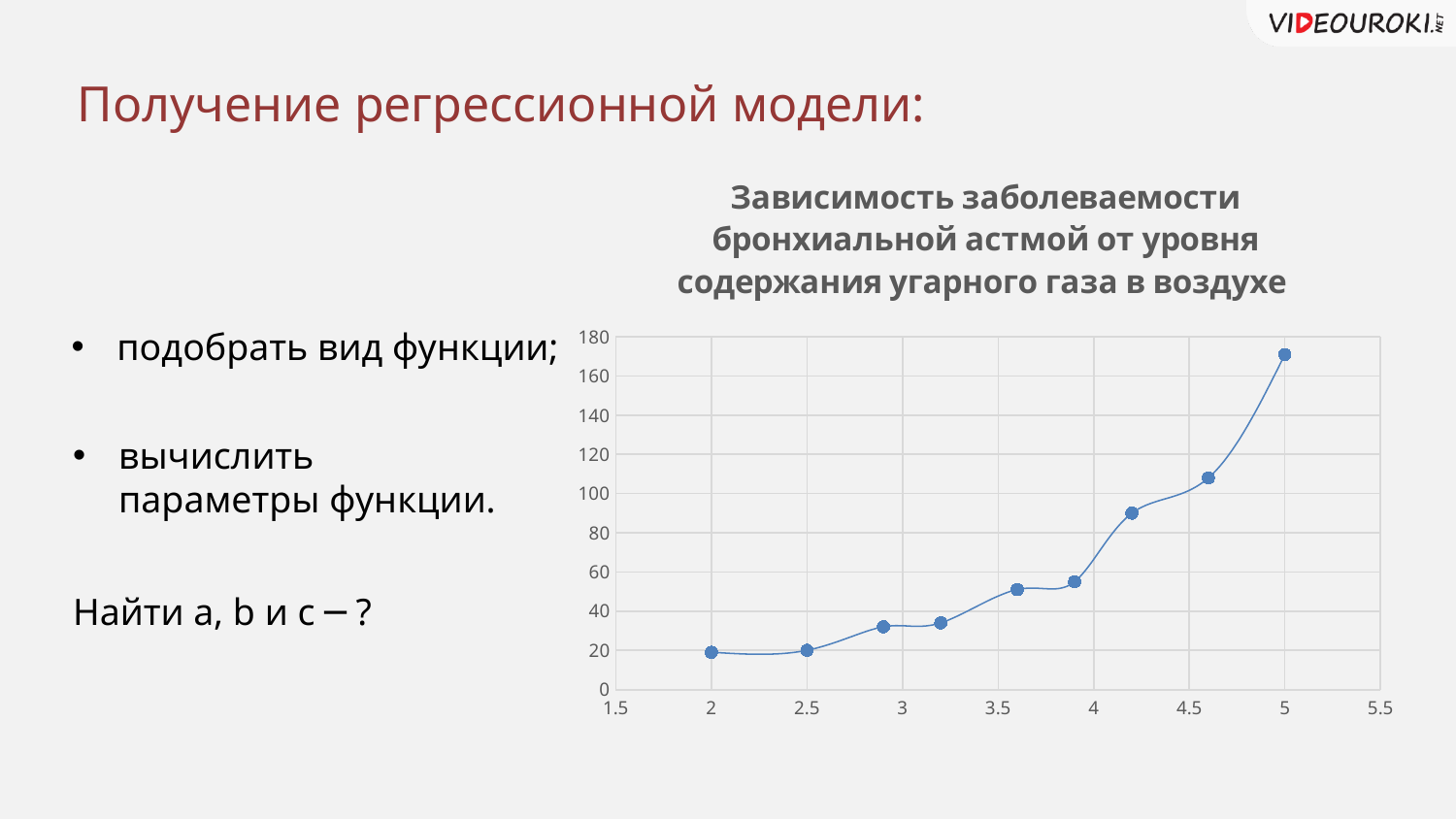
Is the value at x = 5 greater or less than 160? greater Is the value at x = 3.9 greater or less than 60? less How many data points are plotted on the chart? 9 What kind of chart is shown on the slide? scatter chart with a smooth line Do the values rise or fall as the x value increases from 2 to 5? rise Is the value at x = 4.2 greater or less than 100? less At which x value is the plotted value highest? 5 What is the maximum value shown on the vertical axis? 180 What is the title of the chart? Зависимость заболеваемости бронхиальной астмой от уровня содержания угарного газа в воздухе Which is larger: the value at x = 4.6 or the value at x = 4.2? x = 4.6